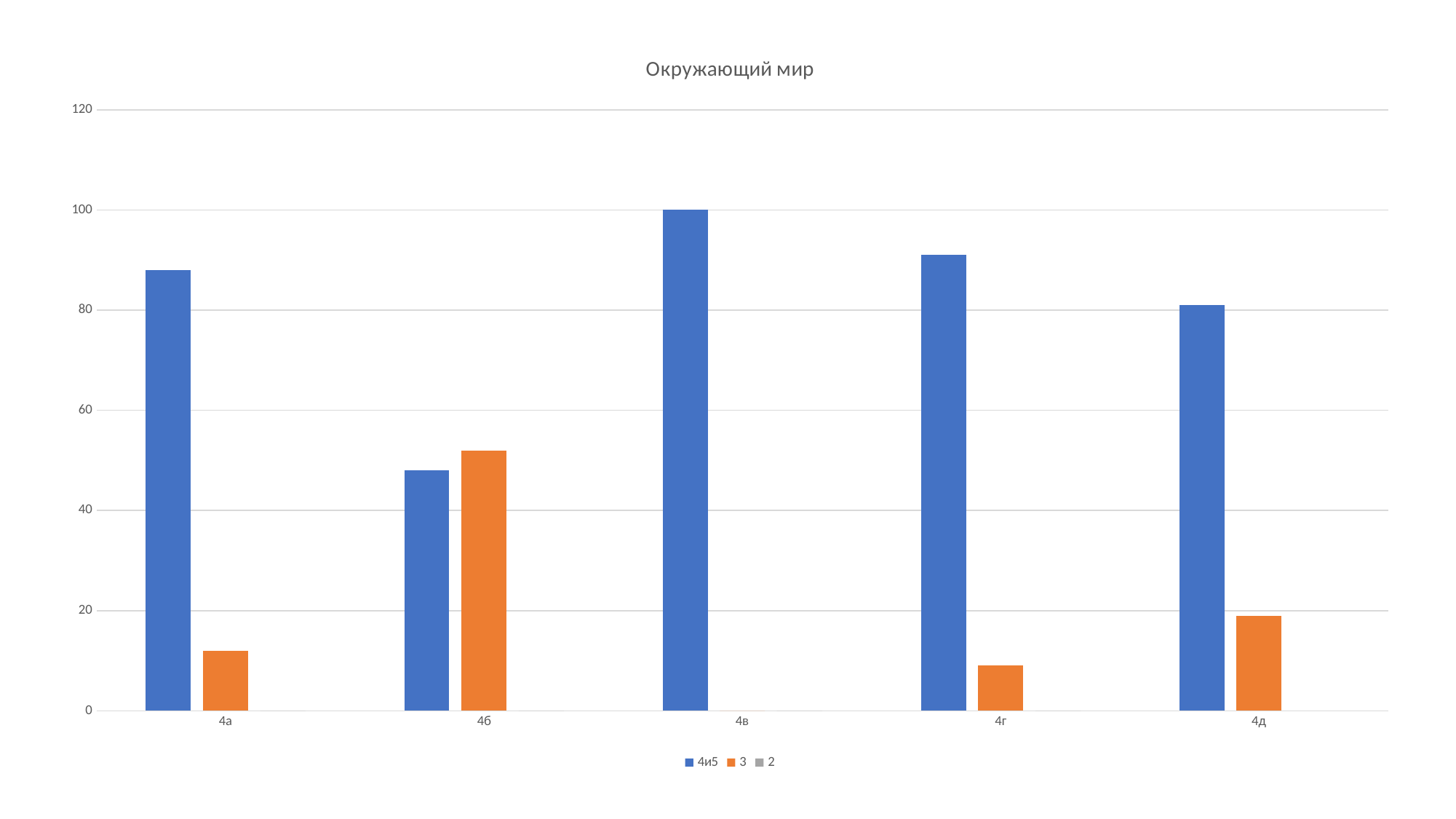
Which category has the highest value for the series 4и5? 4в Which category has the lowest value for the series 4и5? 4б Is the value for 4а in the series 4и5 greater or less than 80? greater For category 4б, which series has the larger value, 4и5 or 3? 3 How many categories are shown on the x axis? 5 Is the value for 4б in the series 4и5 greater or less than 60? less What is the title of the chart? Окружающий мир Which category has the highest value for the series 3? 4б Is the value for 4г in the series 3 greater or less than 20? less How many series does the legend list? 3 What is the value for 4в in the series 4и5? 100 What kind of chart is shown on the slide? bar chart